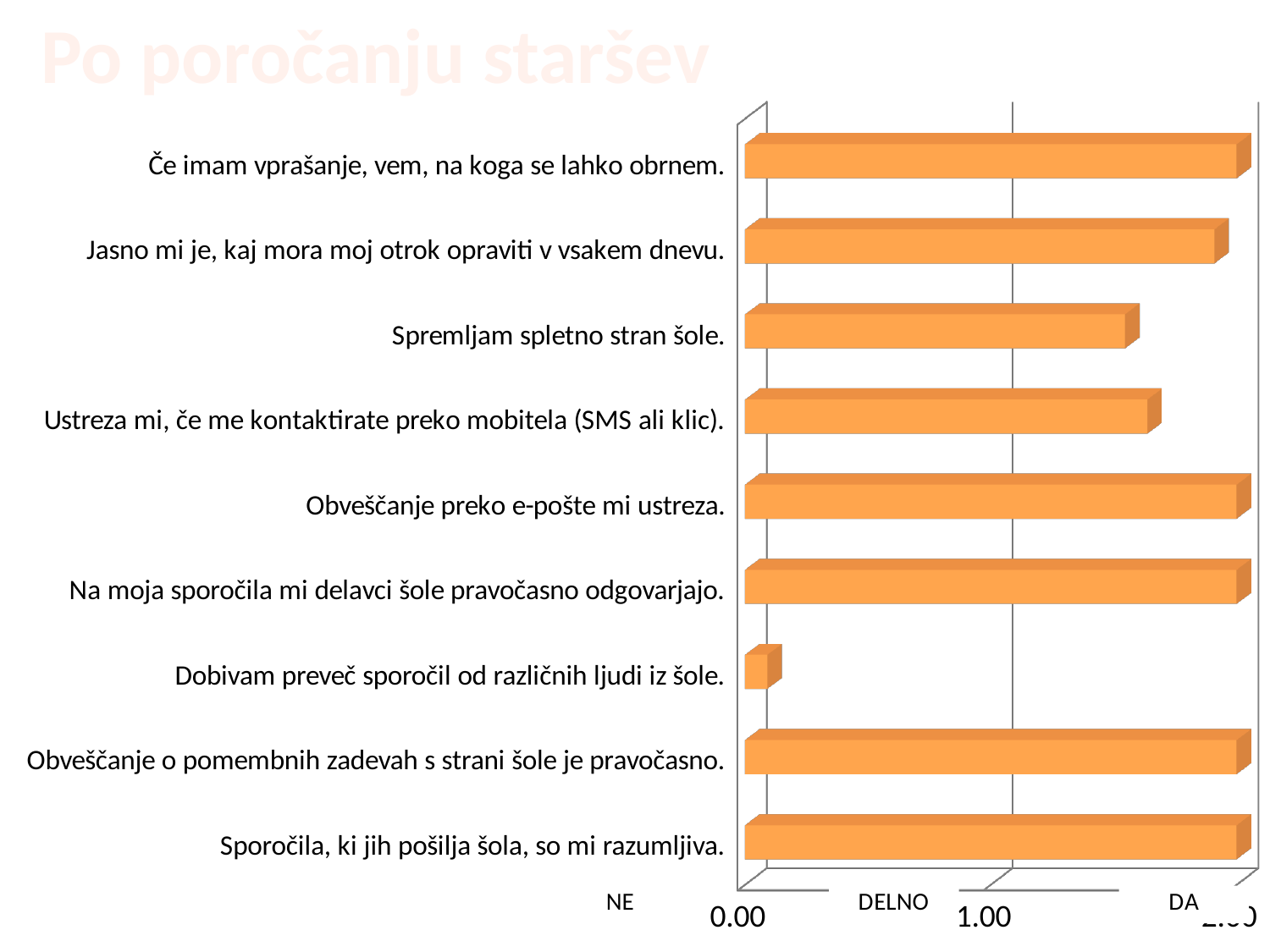
What is the title of the slide? Po poročanju staršev Is the value for "Ustreza mi, če me kontaktirate preko mobitela (SMS ali klic)." greater or less than 1.00? greater Which has the larger value: "Spremljam spletno stran šole." or "Dobivam preveč sporočil od različnih ljudi iz šole."? Spremljam spletno stran šole. Which has the larger value: "Obveščanje preko e-pošte mi ustreza." or "Dobivam preveč sporočil od različnih ljudi iz šole."? Obveščanje preko e-pošte mi ustreza. What kind of chart is shown on the slide? bar chart What three text labels appear along the horizontal axis of the chart? NE, DELNO, DA Is the value for "Sporočila, ki jih pošilja šola, so mi razumljiva." greater or less than 1.00? greater Which statement has the lowest value in the chart? Dobivam preveč sporočil od različnih ljudi iz šole. Is the value for "Spremljam spletno stran šole." greater or less than 1.00? greater How many categories (statements) are plotted in the chart? 9 Which has the larger value: "Jasno mi je, kaj mora moj otrok opraviti v vsakem dnevu." or "Spremljam spletno stran šole."? Jasno mi je, kaj mora moj otrok opraviti v vsakem dnevu.